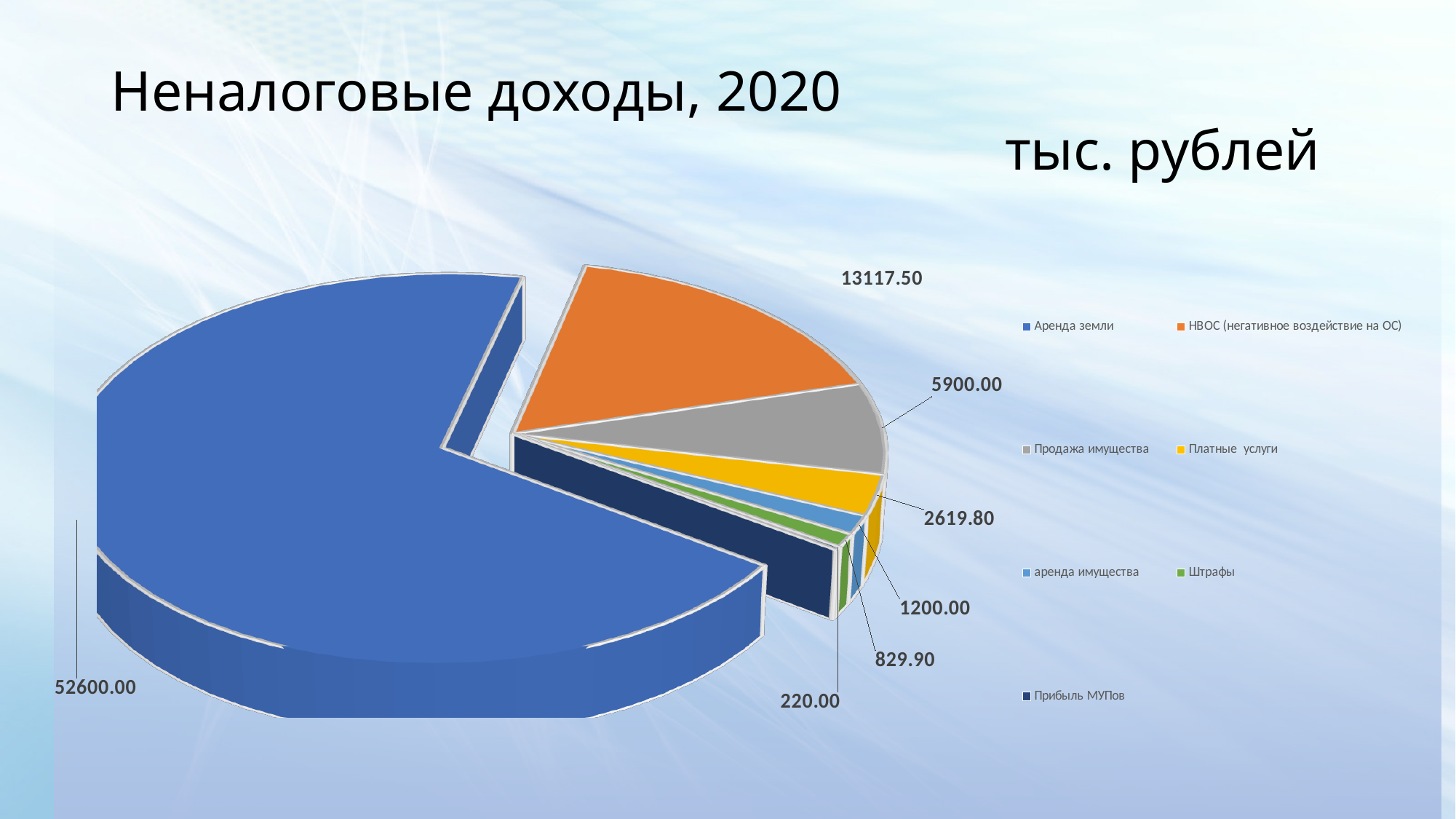
What is the title of the chart on the slide? Неналоговые доходы, 2020 тыс. рублей How many categories does the pie chart have? 7 Which is larger, the value for аренда имущества or the value for Штрафы? аренда имущества What is the value for НВОС (негативное воздействие на ОС)? 13117.50 Which category has the largest slice of the pie? Аренда земли What is the value for Продажа имущества? 5900.00 What is the value for Аренда земли? 52600.00 What is the difference between the values for НВОС (негативное воздействие на ОС) and Продажа имущества? 7217.50 What is the value for Штрафы? 829.90 What is the value for Платные услуги? 2619.80 What kind of chart is shown on the slide? Pie chart Which category has the smallest slice of the pie? Прибыль МУПов